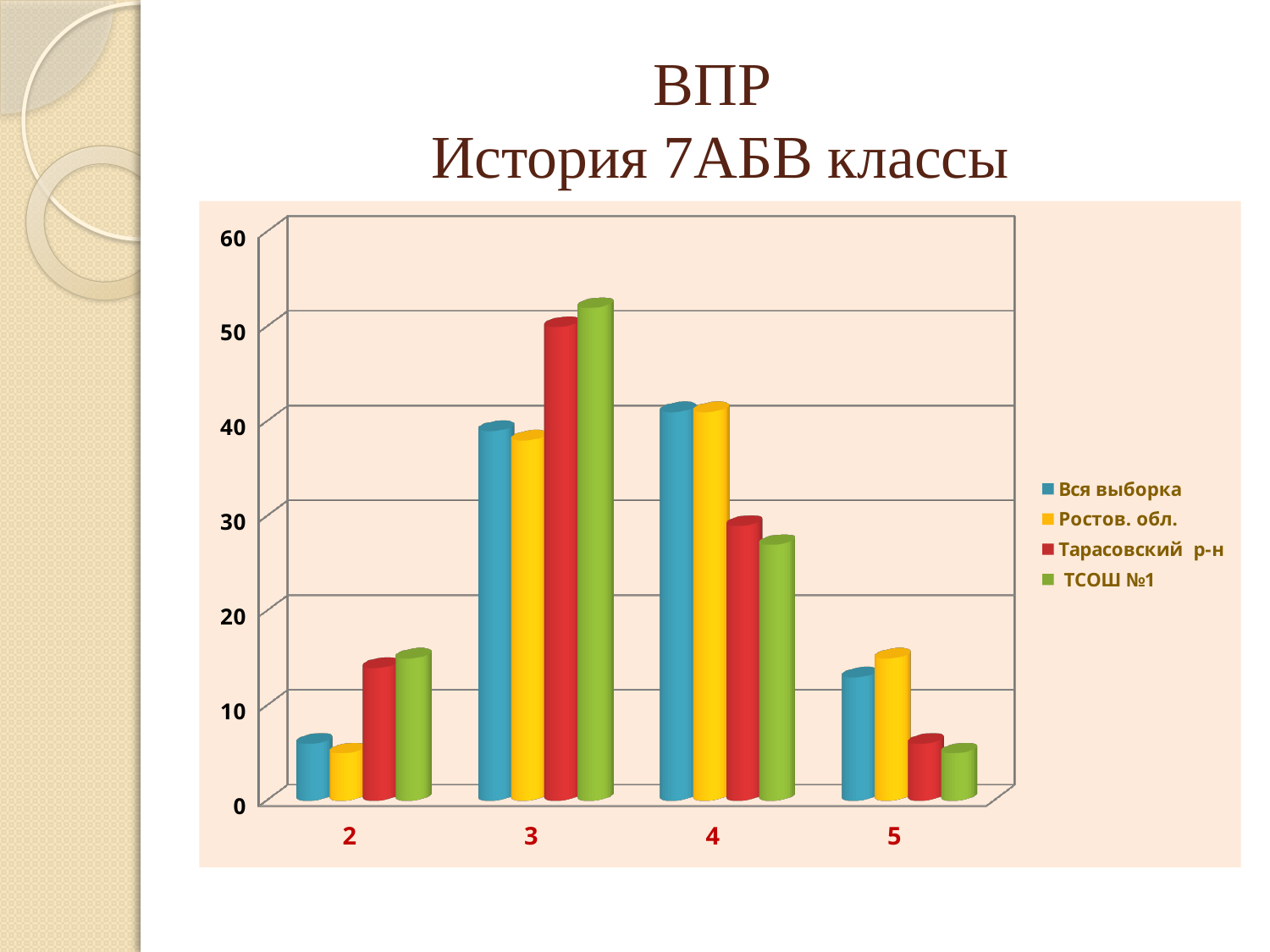
How many categories are shown on the x axis of the chart? 4 Is the value for Тарасовский р-н in category 4 greater or less than 40? less For which category is the ТСОШ №1 series lowest? 5 In category 4, which is larger: Вся выборка or Тарасовский р-н? Вся выборка Is the value for ТСОШ №1 in category 3 greater or less than 40? greater Is the value for Вся выборка in category 2 greater or less than 10? less What kind of chart is shown on the slide? bar chart For which category is the ТСОШ №1 series highest? 3 How many series does the legend list? 4 Which series is shown in green in the legend? ТСОШ №1 In category 2, which is larger: ТСОШ №1 or Вся выборка? ТСОШ №1